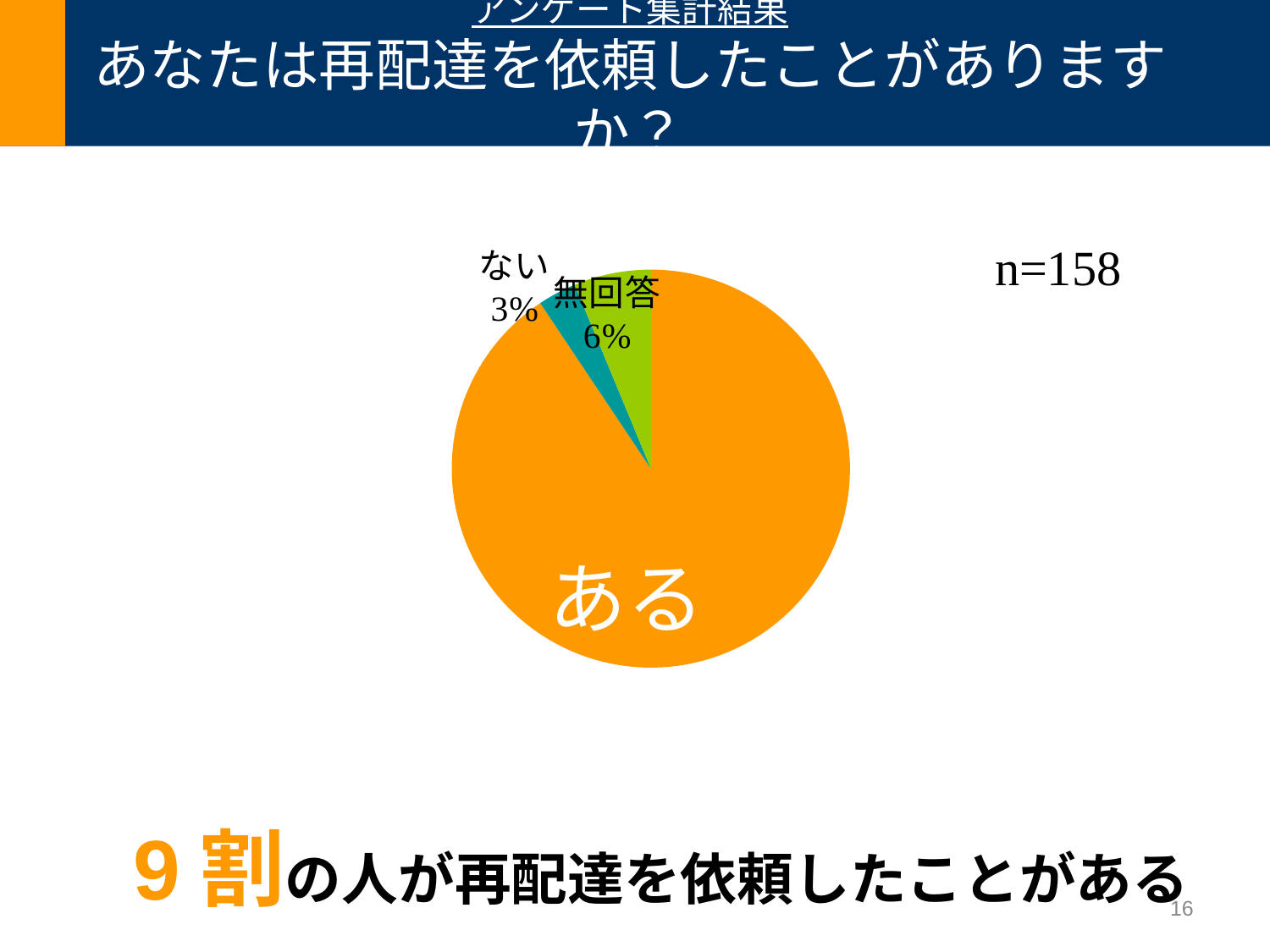
What percentage is shown for the ない slice? 3% What kind of chart is shown on the slide? pie chart Which slice of the pie chart is the smallest? ない Which slice of the pie chart is the largest? ある What is the difference in percentage points between the 無回答 slice and the ない slice? 3 How many slices does the pie chart have? 3 What sample size (n) is shown next to the pie chart? n=158 What percentage is shown for the 無回答 slice? 6% What colour is the ある slice of the pie chart? orange Which is larger, the ない slice or the 無回答 slice? 無回答